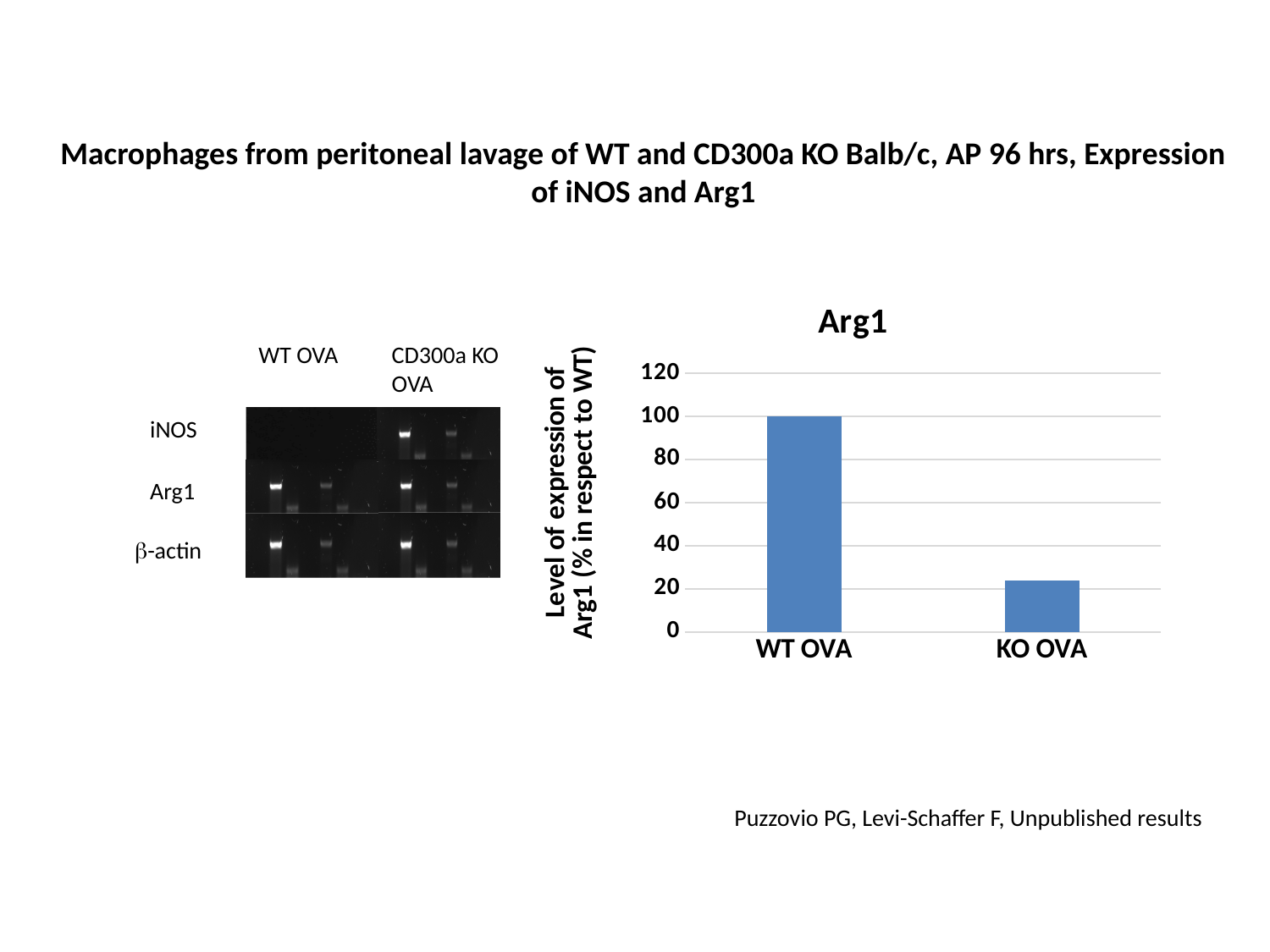
In the Arg1 chart, is the value for KO OVA greater or less than 20? greater Which category has the lowest value in the Arg1 chart? KO OVA Do the values in the Arg1 chart rise or fall from left to right along the x axis? fall What kind of chart is the Arg1 chart? bar chart How many categories are shown on the x axis of the Arg1 chart? 2 What is the value for WT OVA in the Arg1 chart? 100 In the Arg1 chart, is the value for WT OVA greater or less than 80? greater In the Arg1 chart, is the value for KO OVA greater or less than 40? less In the Arg1 chart, which is larger, the value for WT OVA or the value for KO OVA? WT OVA What is the title of the bar chart on the slide? Arg1 Which category has the highest value in the Arg1 chart? WT OVA What is the y-axis label of the Arg1 chart? Level of expression of Arg1 (% in respect to WT)